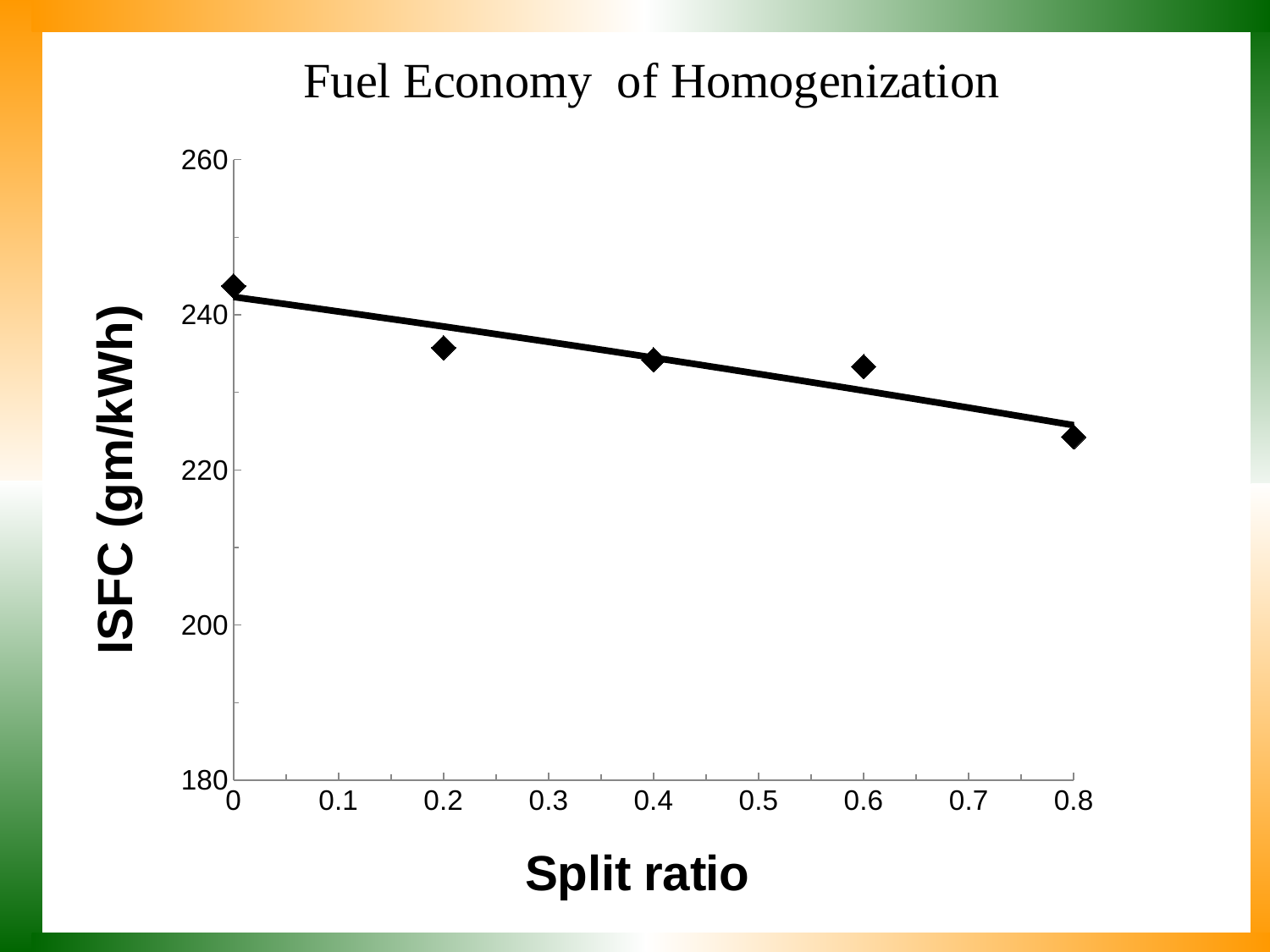
Does ISFC rise or fall as the split ratio increases? fall Is the ISFC value at split ratio 0 greater or less than 240? greater What is the label of the y axis? ISFC (gm/kWh) Is the ISFC value at split ratio 0.8 greater or less than 220? greater How many data points are plotted on the chart? 5 Is the ISFC value at split ratio 0.2 greater or less than 240? less Which has the larger ISFC value, split ratio 0 or split ratio 0.8? split ratio 0 At which split ratio is ISFC highest? 0 What kind of chart is shown on the slide? scatter chart What is the title of the chart? Fuel Economy of Homogenization At which split ratio is ISFC lowest? 0.8